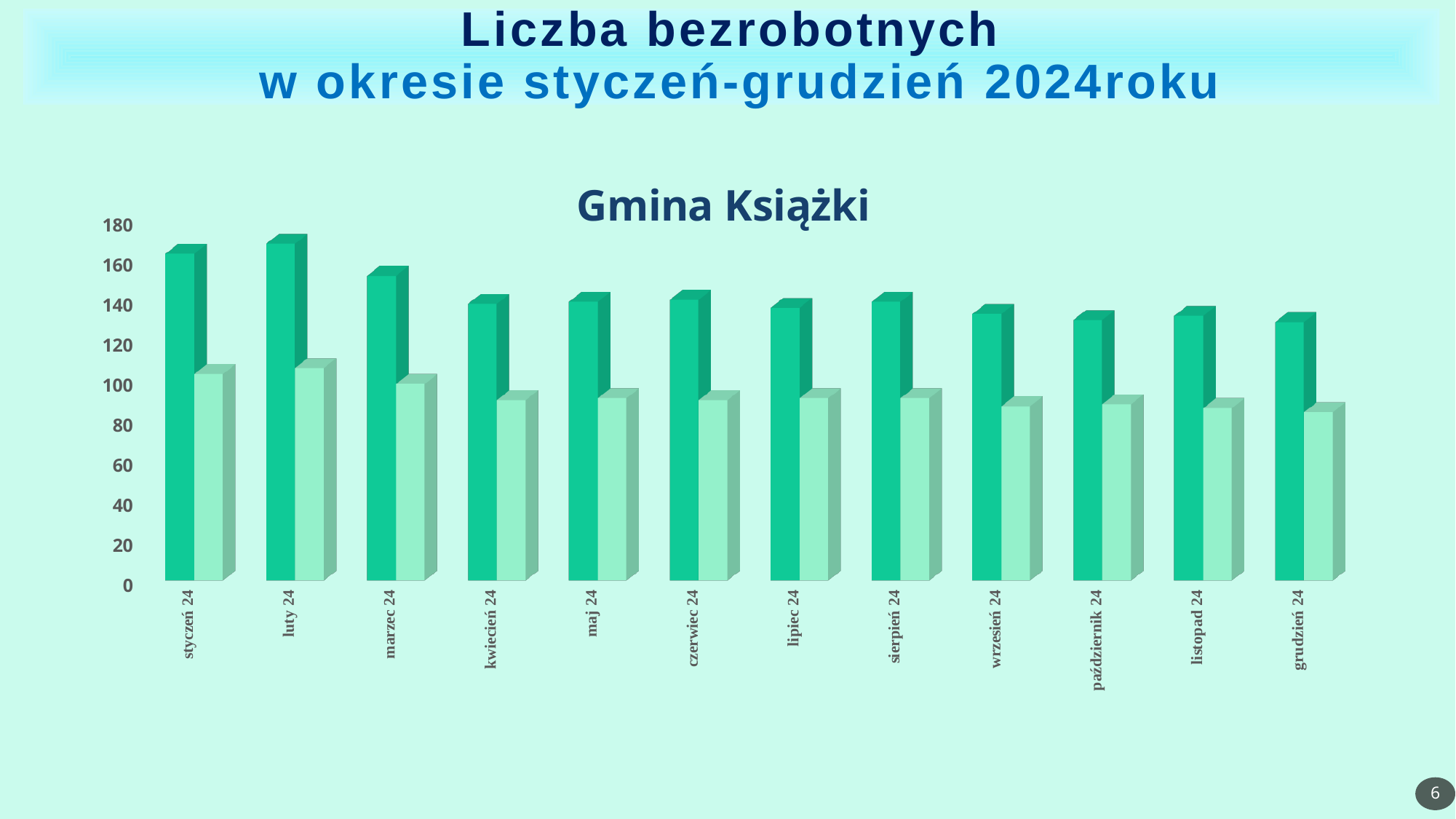
Which month has the highest darker green bar? luty 24 What is the title of the chart? Gmina Książki Is the lighter green bar for grudzień 24 greater or less than 100? less Is the darker green bar for marzec 24 greater or less than 140? greater Which month has the highest lighter green bar? luty 24 Do the darker green bars generally rise or fall from styczeń 24 to grudzień 24? fall Is the lighter green bar for luty 24 greater or less than 100? greater What is the highest value shown on the vertical axis of the chart? 180 How many months are shown on the x axis of the chart? 12 What kind of chart is shown on the slide? bar chart Which is larger, the darker green bar for luty 24 or the darker green bar for grudzień 24? luty 24